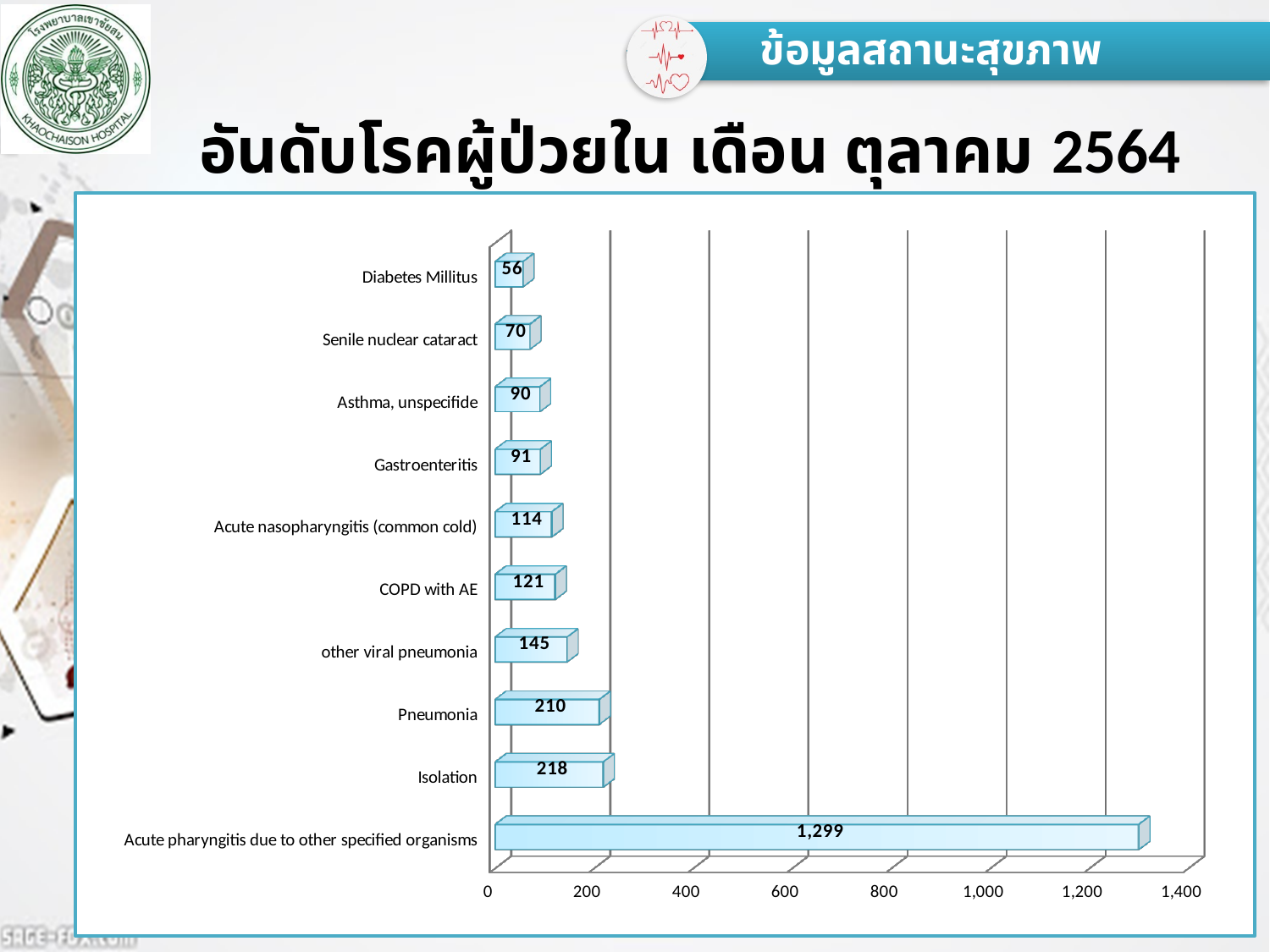
Which category has the lowest value? Diabetes Millitus What is the value for Acute pharyngitis due to other specified organisms? 1,299 How many categories are shown in the chart? 10 Which category has the highest value? Acute pharyngitis due to other specified organisms Is the value for Isolation greater or less than 200? greater Which is larger, the value for Asthma, unspecifide or the value for Gastroenteritis? Gastroenteritis What is the value for COPD with AE? 121 What is the difference between the values for other viral pneumonia and Acute nasopharyngitis (common cold)? 31 What is the difference between the values for Isolation and Pneumonia? 8 What is the value for Senile nuclear cataract? 70 What is the value for Pneumonia? 210 What kind of chart is shown on the slide? bar chart